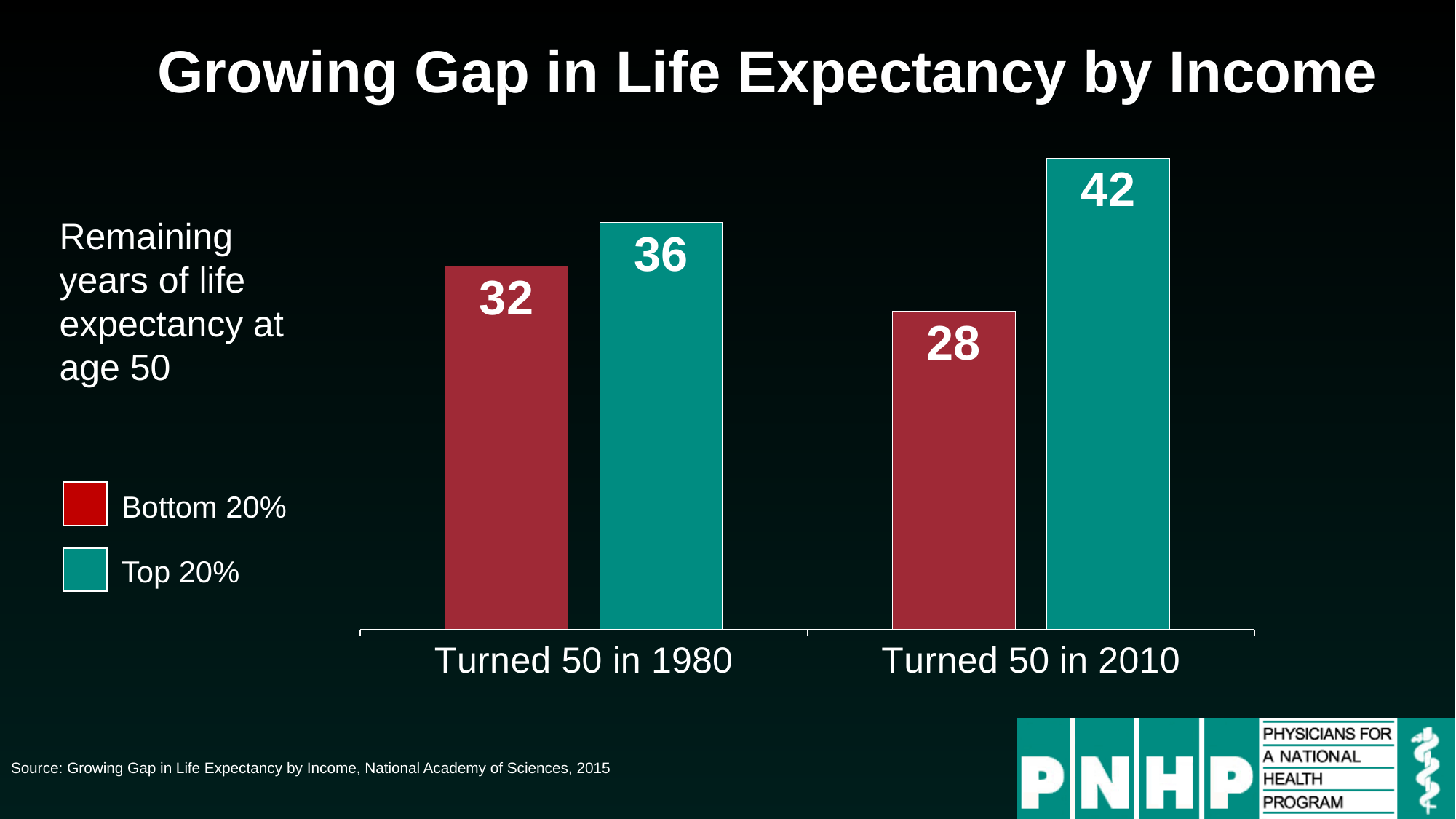
Which bar has the highest value on the chart? Top 20%, Turned 50 in 2010 What is the difference between the Top 20% and Bottom 20% values for those who turned 50 in 1980? 4 What kind of chart is shown on the slide? Bar chart What is the value for the Top 20% in the 'Turned 50 in 1980' group? 36 How many series does the legend list? 2 What is the difference between the Top 20% and Bottom 20% values for those who turned 50 in 2010? 14 What is the remaining life expectancy at age 50 for the Top 20% who turned 50 in 2010? 42 Which is larger: the Bottom 20% value for 1980 or the Bottom 20% value for 2010? Bottom 20% value for 1980 What colour represents the Top 20% in the chart? Teal What is the remaining life expectancy at age 50 for the Bottom 20% who turned 50 in 1980? 32 Which bar has the lowest value on the chart? Bottom 20%, Turned 50 in 2010 What is the value for the Bottom 20% in the 'Turned 50 in 2010' group? 28